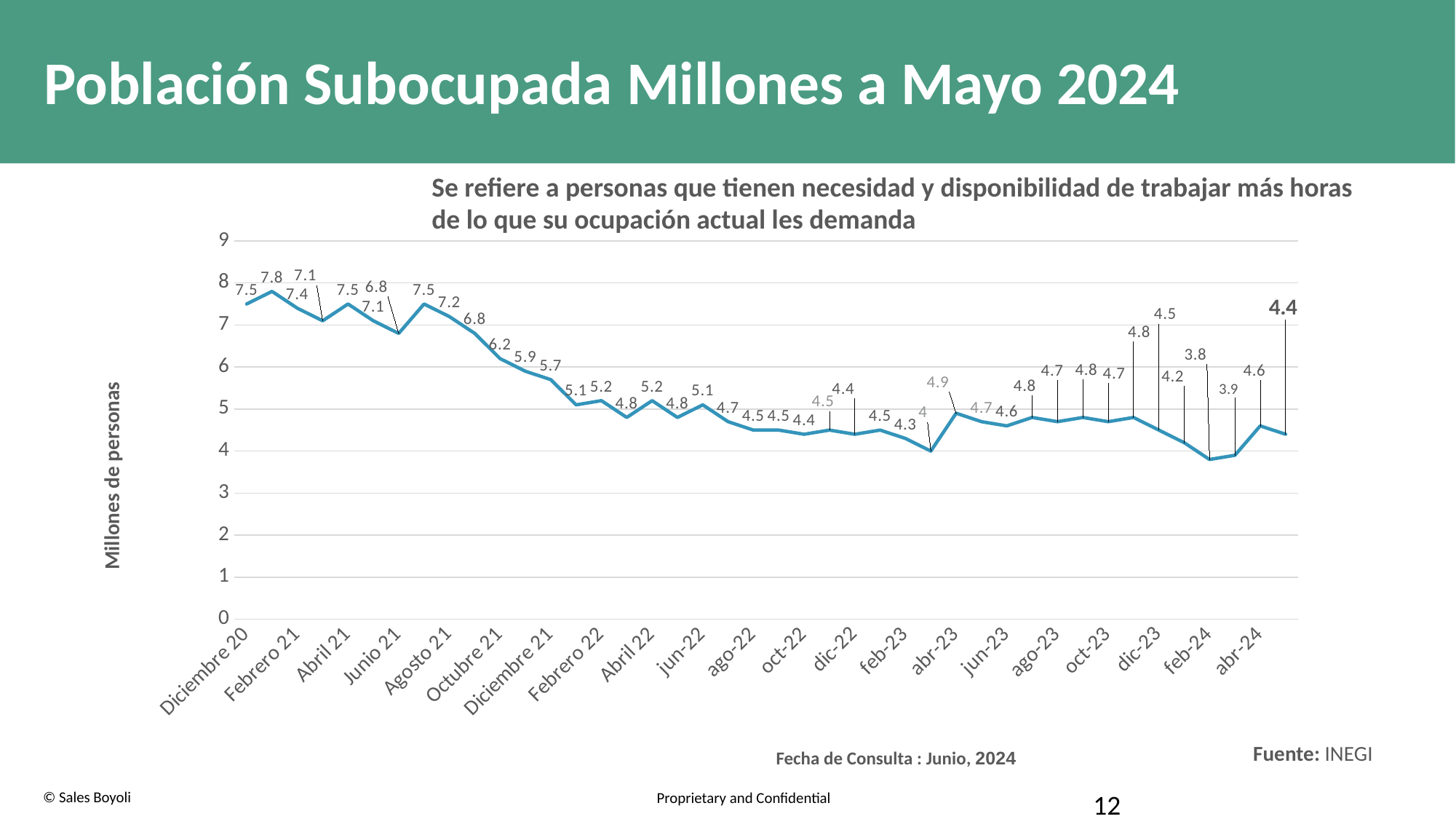
What is the highest value shown on the line? 7.8 What is the value for abr-24? 4.6 Which labelled month on the x axis has the lowest value? feb-24 What is the value for Octubre 21? 6.2 What is the difference between the value for Diciembre 20 and the value for abr-24? 2.9 Overall, do the values rise or fall from Diciembre 20 to abr-24? fall What is the value for feb-24? 3.8 What is the last value plotted on the line (May 2024)? 4.4 What is the value for Diciembre 20? 7.5 What is the value for abr-23? 4.9 Which is larger, the value for Abril 21 or the value for Agosto 21? Abril 21 What kind of chart is shown on the slide? line chart